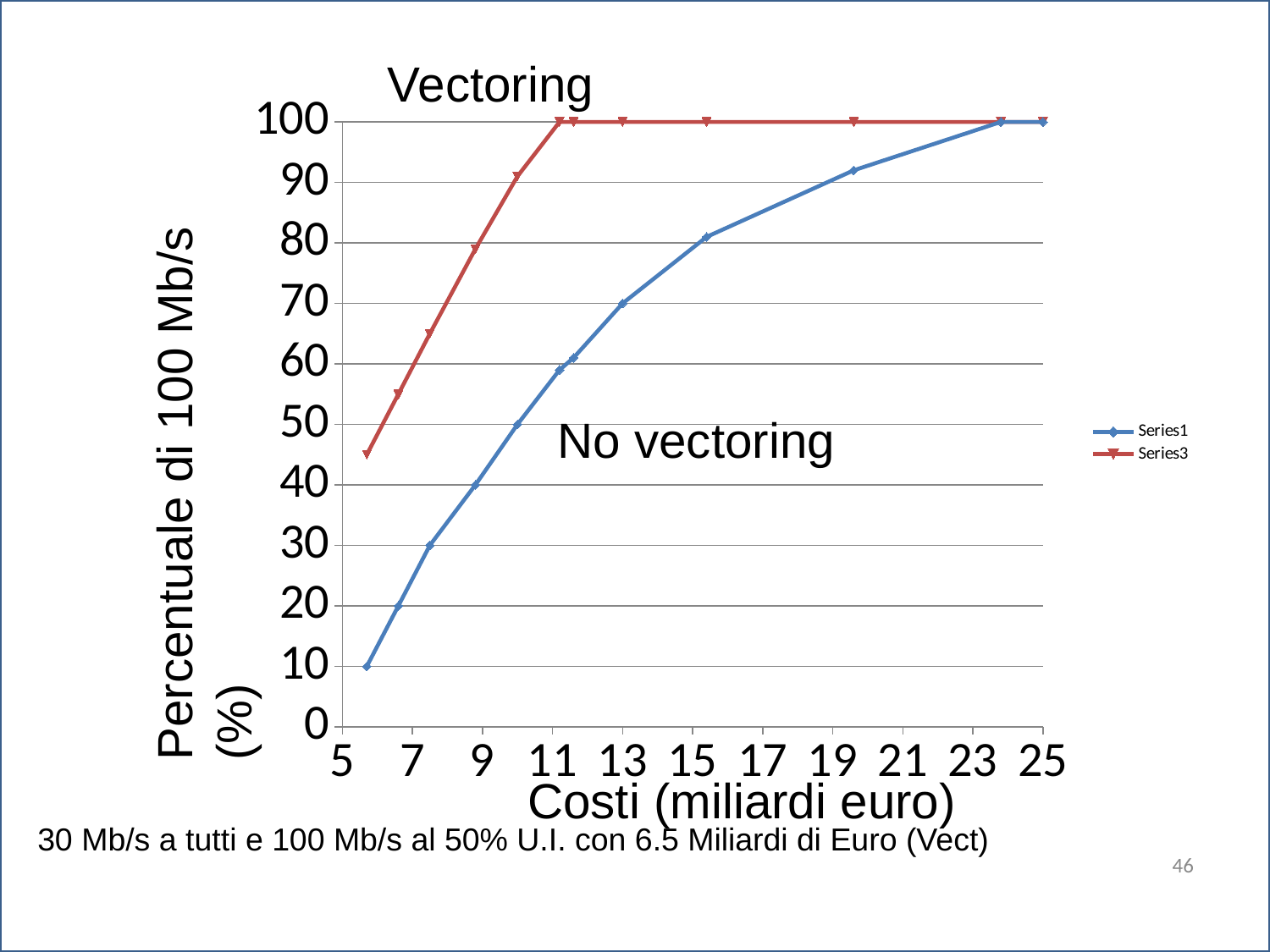
What is the value of Series1 at its first plotted point (lowest cost)? 10 Is the value of Series1 at a cost of 15 greater or less than 70? greater How many series does the legend list? 2 What is the value of Series1 at its last plotted point (cost 25)? 100 Does the value of Series1 rise or fall as cost increases along the x axis? rise At a cost of 13 billion euro, which series has the higher value, Series1 or Series3? Series3 What is the title of the x axis? Costi (miliardi euro) Which series reaches 100% at a lower cost, Series1 or Series3? Series3 What value does Series3 stay at from a cost of about 11 up to 25? 100 What are the names of the series listed in the legend? Series1, Series3 What kind of chart is shown on the slide? line chart Is the value of Series3 at its first plotted point greater or less than 50? less